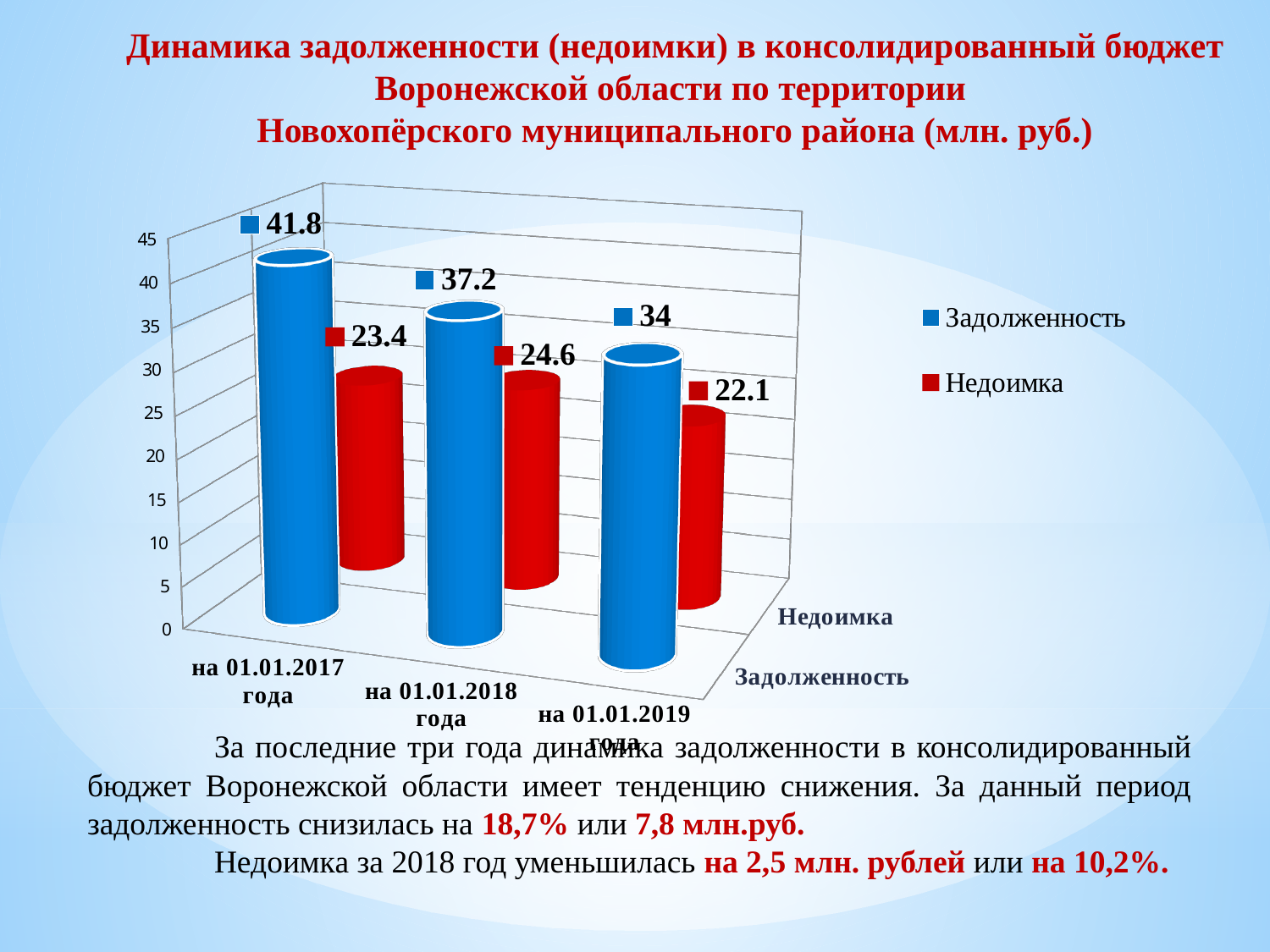
How many dates are shown on the x axis? 3 What is the value of Недоимка on 01.01.2019? 22.1 What kind of chart is shown on the slide? bar chart On which date is Недоимка lowest? на 01.01.2019 года What is the value of Задолженность on 01.01.2019? 34 How many series does the legend list? 2 Which is larger: Недоимка on 01.01.2017 or Недоимка on 01.01.2018? Недоимка on 01.01.2018 Does Задолженность rise or fall from 01.01.2017 to 01.01.2019? fall What is the value of Недоимка on 01.01.2018? 24.6 What is the difference between Задолженность on 01.01.2017 and on 01.01.2019? 7.8 On which date is Задолженность highest? на 01.01.2017 года What is the value of Задолженность on 01.01.2017? 41.8